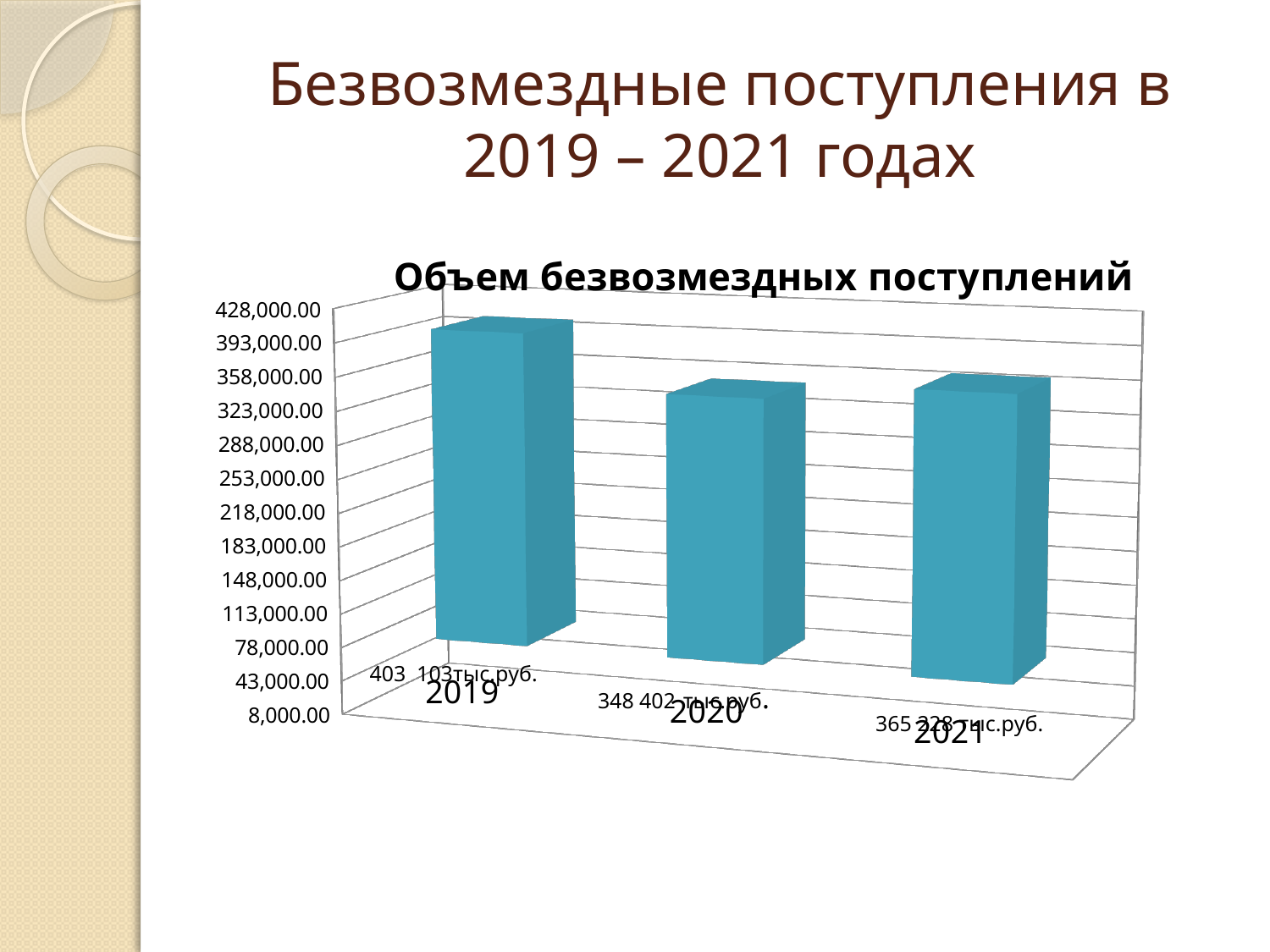
Does the value rise or fall from 2019 to 2020? fall What kind of chart is shown on the slide? bar chart Which is larger, the value for 2020 or the value for 2021? 2021 What is the difference between the values for 2019 and 2020? 54 701 тыс.руб. What is the title of the chart? Объем безвозмездных поступлений What is the value for 2020? 348 402 тыс.руб. Which year has the highest value? 2019 How many years are shown on the chart? 3 What is the value for 2019? 403 103 тыс.руб. What is the value for 2021? 365 228 тыс.руб. Which year has the lowest value? 2020 Is the value for 2020 greater or less than 358,000.00? less